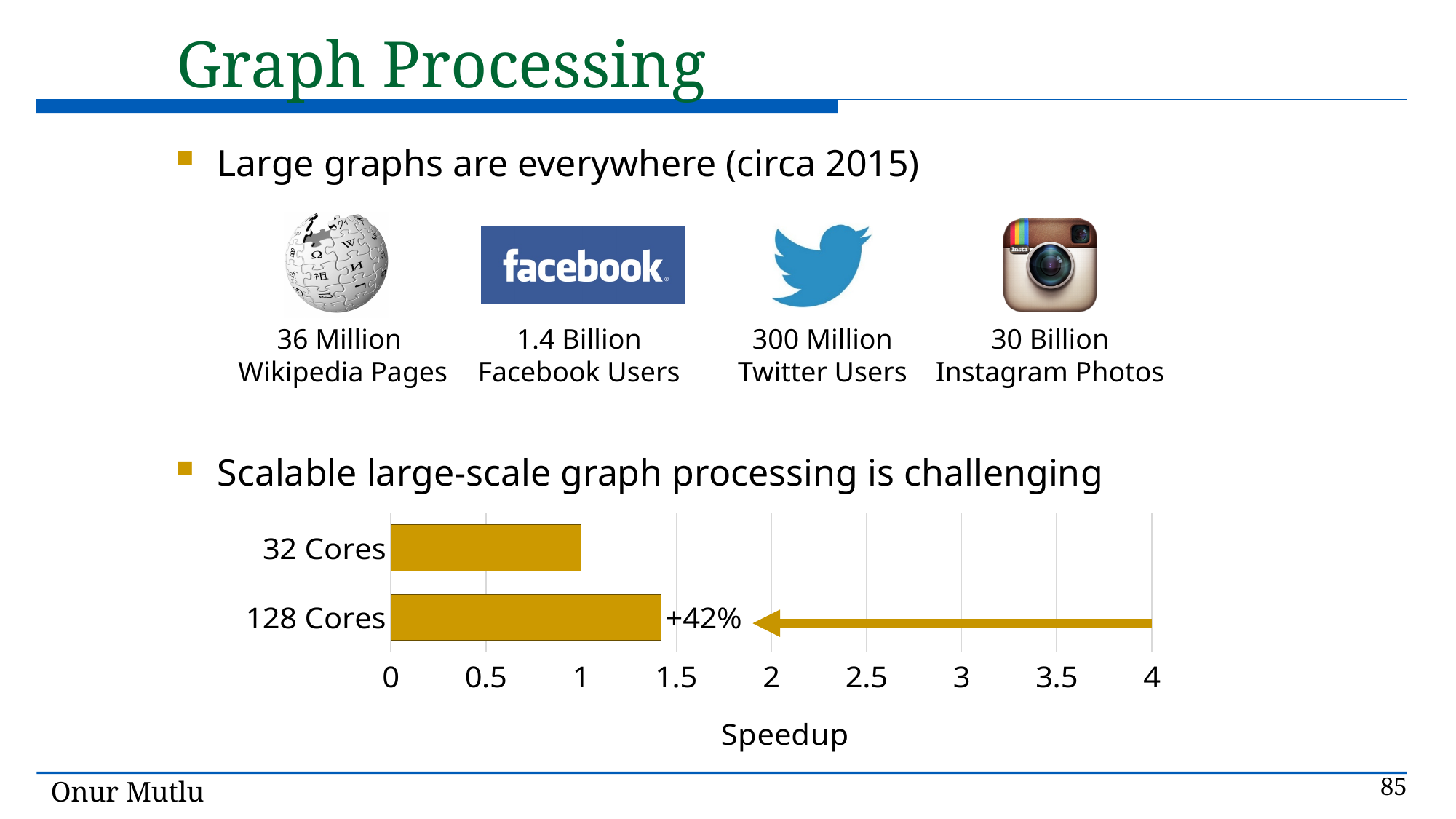
Which category has the highest speedup? 128 Cores Is the speedup for 128 Cores greater or less than 2? less What label is printed next to the 128 Cores bar? +42% Which category has the lowest speedup? 32 Cores What is the highest value shown on the x axis of the chart? 4 What is the label of the x axis of the chart? Speedup Is the speedup for 128 Cores greater or less than 1.5? less How many categories are plotted in the chart? 2 What kind of chart is shown on the slide? bar chart What is the speedup value for 32 Cores? 1 Is the speedup for 128 Cores greater or less than 1? greater Which has a larger speedup, 32 Cores or 128 Cores? 128 Cores